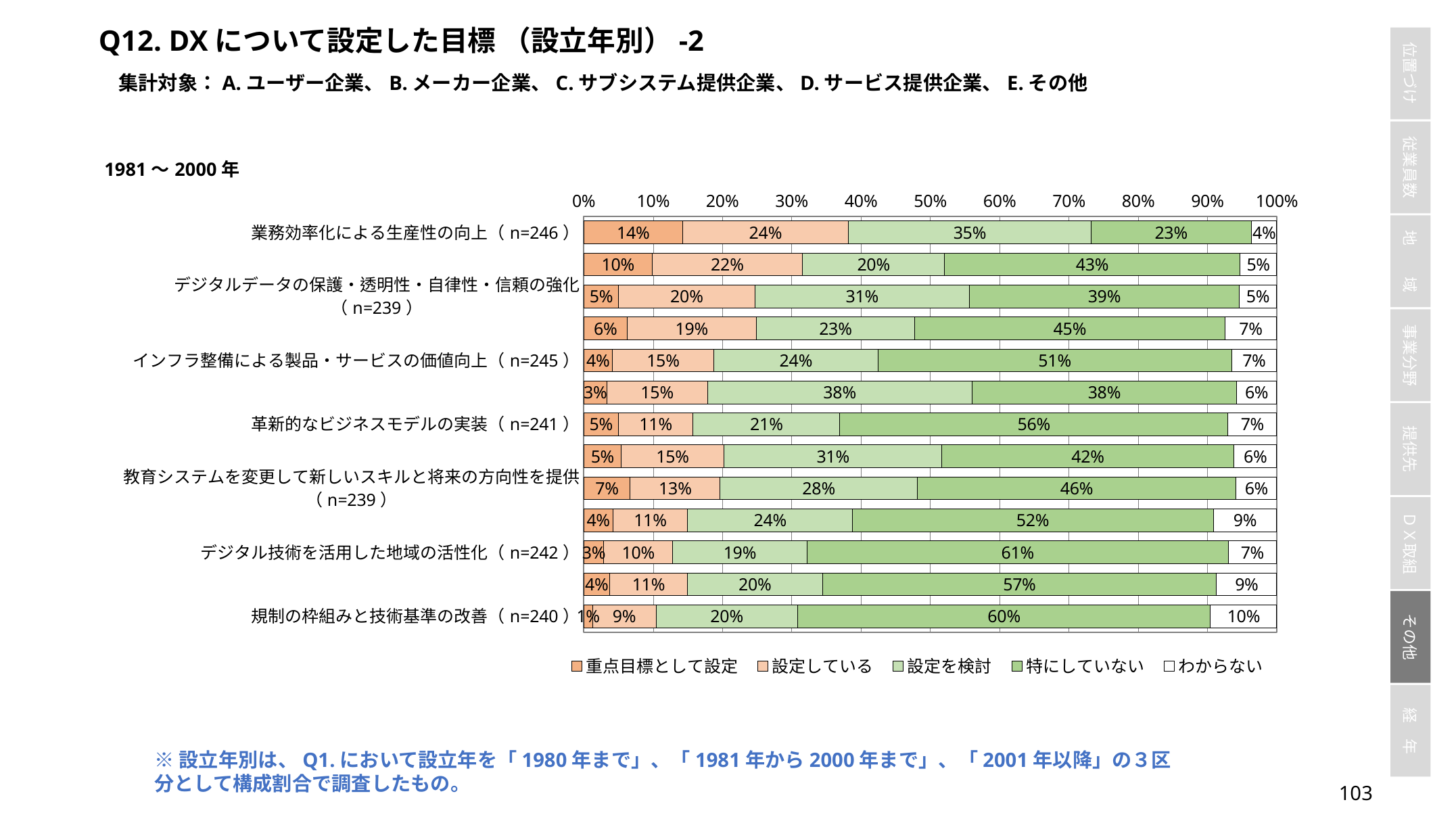
What is the 特にしていない value for デジタル技術を活用した地域の活性化 (n=242)? 61% What percentage of respondents for 業務効率化による生産性の向上 (n=246) selected 重点目標として設定? 14% What is the わからない value for 規制の枠組みと技術基準の改善 (n=240)? 10% Which has a larger 重点目標として設定 share: 業務効率化による生産性の向上 (n=246) or 規制の枠組みと技術基準の改善 (n=240)? 業務効率化による生産性の向上 What is the 設定している value for 革新的なビジネスモデルの実装 (n=241)? 11% What is the first entry in the chart legend? 重点目標として設定 For 業務効率化による生産性の向上 (n=246), how much larger is the 設定している share than the 重点目標として設定 share? 10 percentage points What kind of chart is shown on the slide? Stacked bar chart How many series does the legend list? 5 Which response category has the largest share for デジタル技術を活用した地域の活性化 (n=242)? 特にしていない What is the 設定を検討 value for インフラ整備による製品・サービスの価値向上 (n=245)? 24% What is the 特にしていない value for 革新的なビジネスモデルの実装 (n=241)? 56%